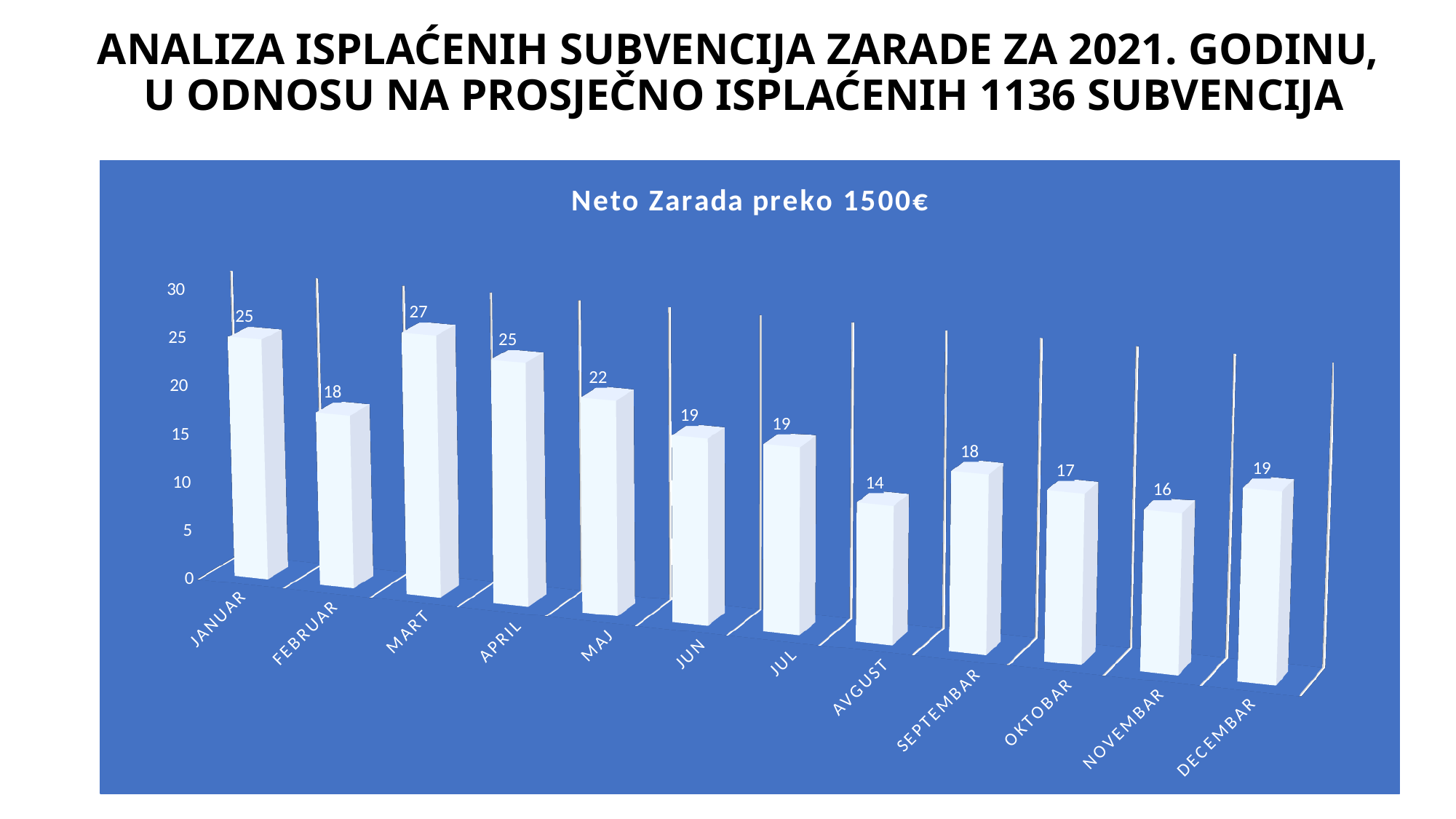
What kind of chart is shown? bar chart What is the value for AVGUST? 14 How many months are shown on the x axis? 12 Do the values generally rise or fall from JANUAR to AVGUST? fall Which is larger, the value for FEBRUAR or the value for MAJ? MAJ What is the value for MART? 27 What is the title of the chart? Neto Zarada preko 1500€ Which month has the highest value? MART What is the difference between the values for MART and AVGUST? 13 Is the value for JANUAR greater or less than 20? greater What is the value for NOVEMBAR? 16 Which month has the lowest value? AVGUST